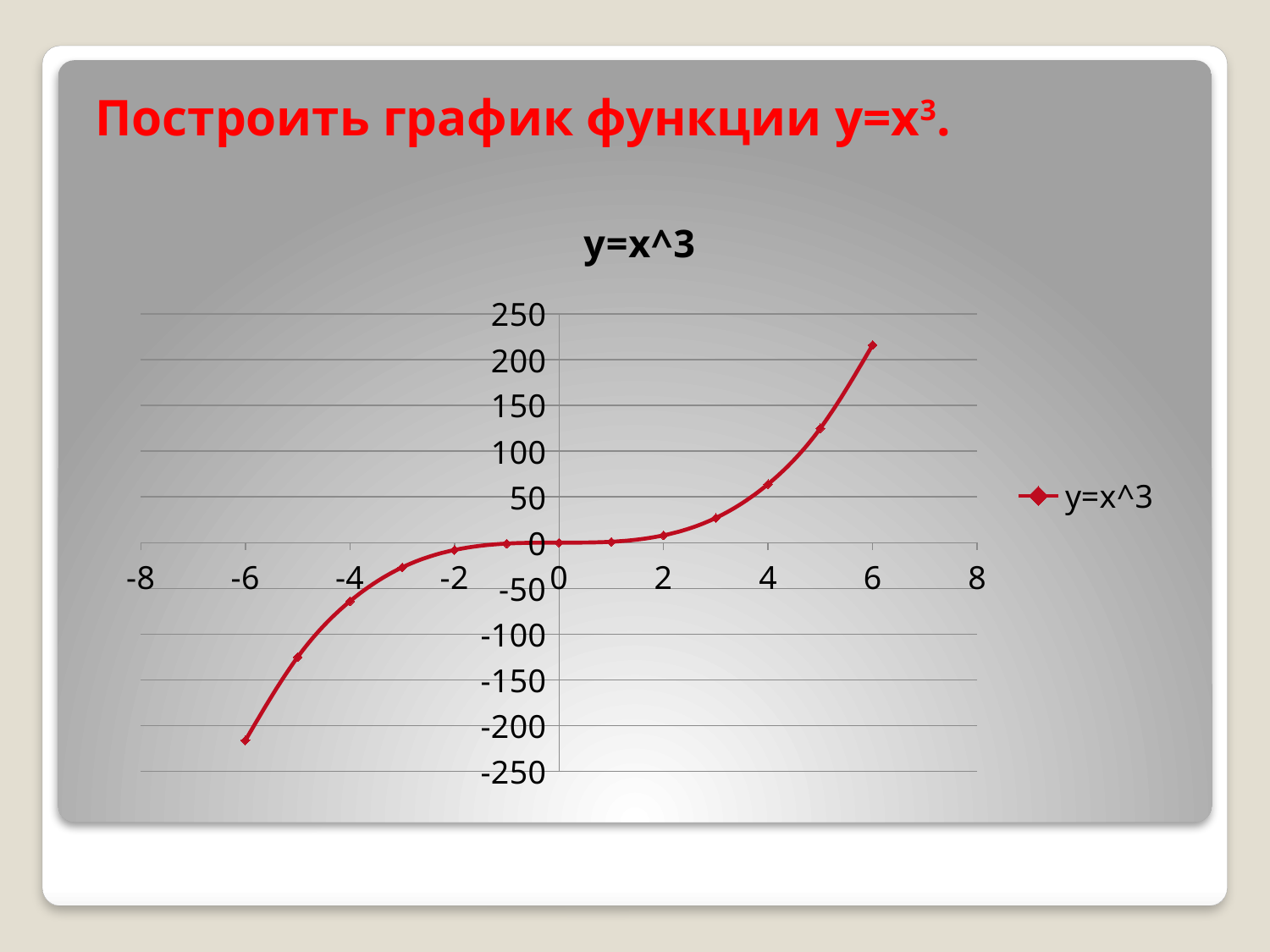
At which x value is the plotted y value highest? 6 Do the values rise or fall as x increases from -6 to 6? rise Is the y value at x = 5 greater or less than 100? greater What is the y value at x = 0? 0 What is the title of the chart? y=x^3 Which is larger, the y value at x = 4 or the y value at x = 2? x = 4 Is the y value at x = 6 greater or less than 200? greater How many series does the legend list? 1 What kind of chart is shown on the slide? line chart At which x value is the plotted y value lowest? -6 Is the y value at x = -6 greater or less than -200? less How many data points are plotted on the line? 13